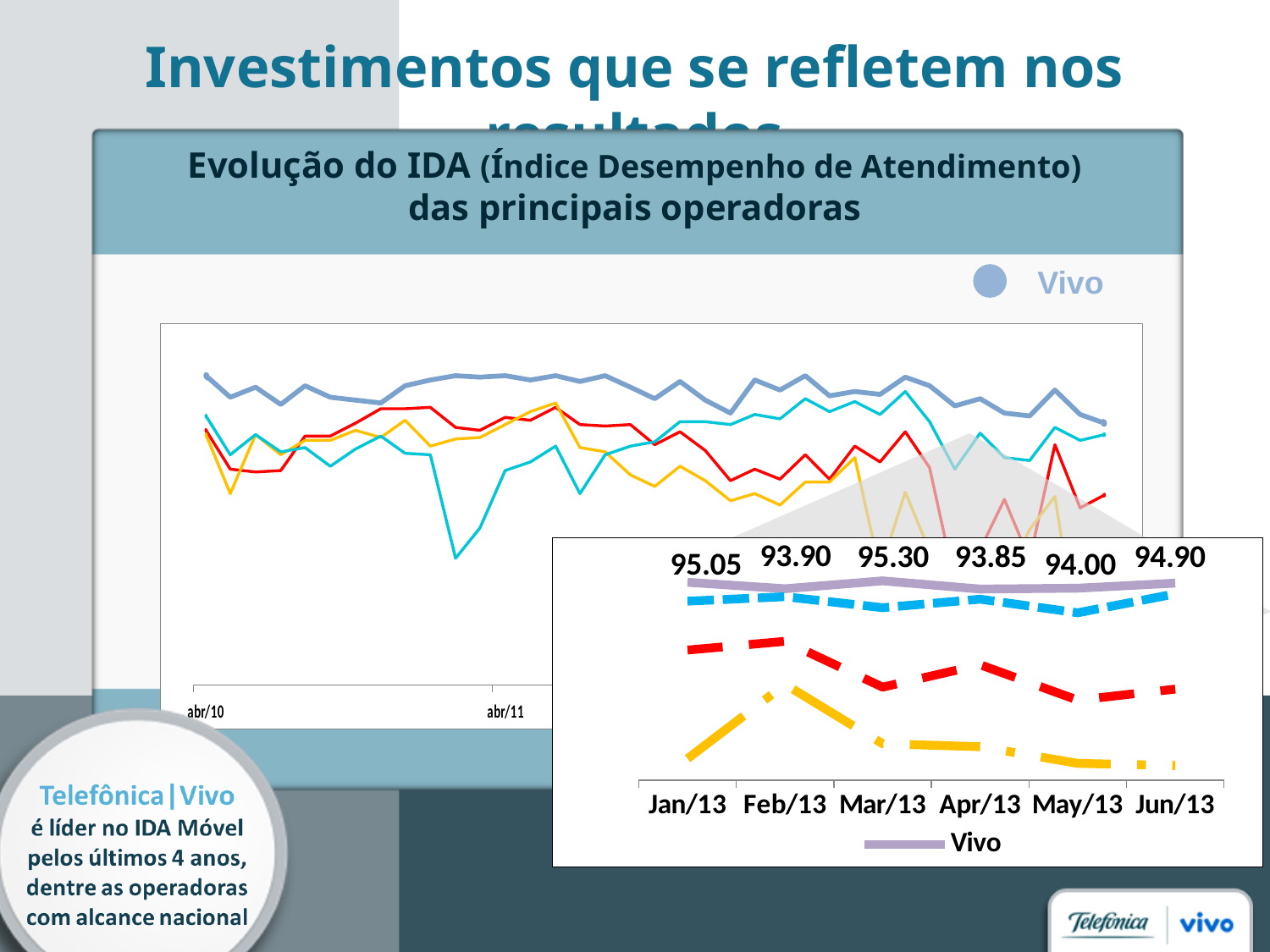
In the inset chart at the bottom right, what is the Vivo value for Jun/13? 94.90 In the inset chart at the bottom right, which month has the lowest Vivo value? Apr/13 In the inset chart at the bottom right, which month has the highest Vivo value? Mar/13 What kind of chart is the inset chart at the bottom right? Line chart In the inset chart at the bottom right, what is the difference between the Vivo values for Jan/13 and Feb/13? 1.15 In the inset chart at the bottom right, what is the difference between the Vivo values for Mar/13 and Apr/13? 1.45 In the inset chart at the bottom right, what is the Vivo value for Mar/13? 95.30 In the inset chart at the bottom right, how many months are shown on the x axis? 6 In the inset chart at the bottom right, does the Vivo value rise or fall from Apr/13 to Jun/13? Rise In the inset chart at the bottom right, how many series does the legend list? 1 In the inset chart at the bottom right, what is the Vivo value for Jan/13? 95.05 In the inset chart at the bottom right, which is larger, the Vivo value for Jan/13 or for Jun/13? Jan/13